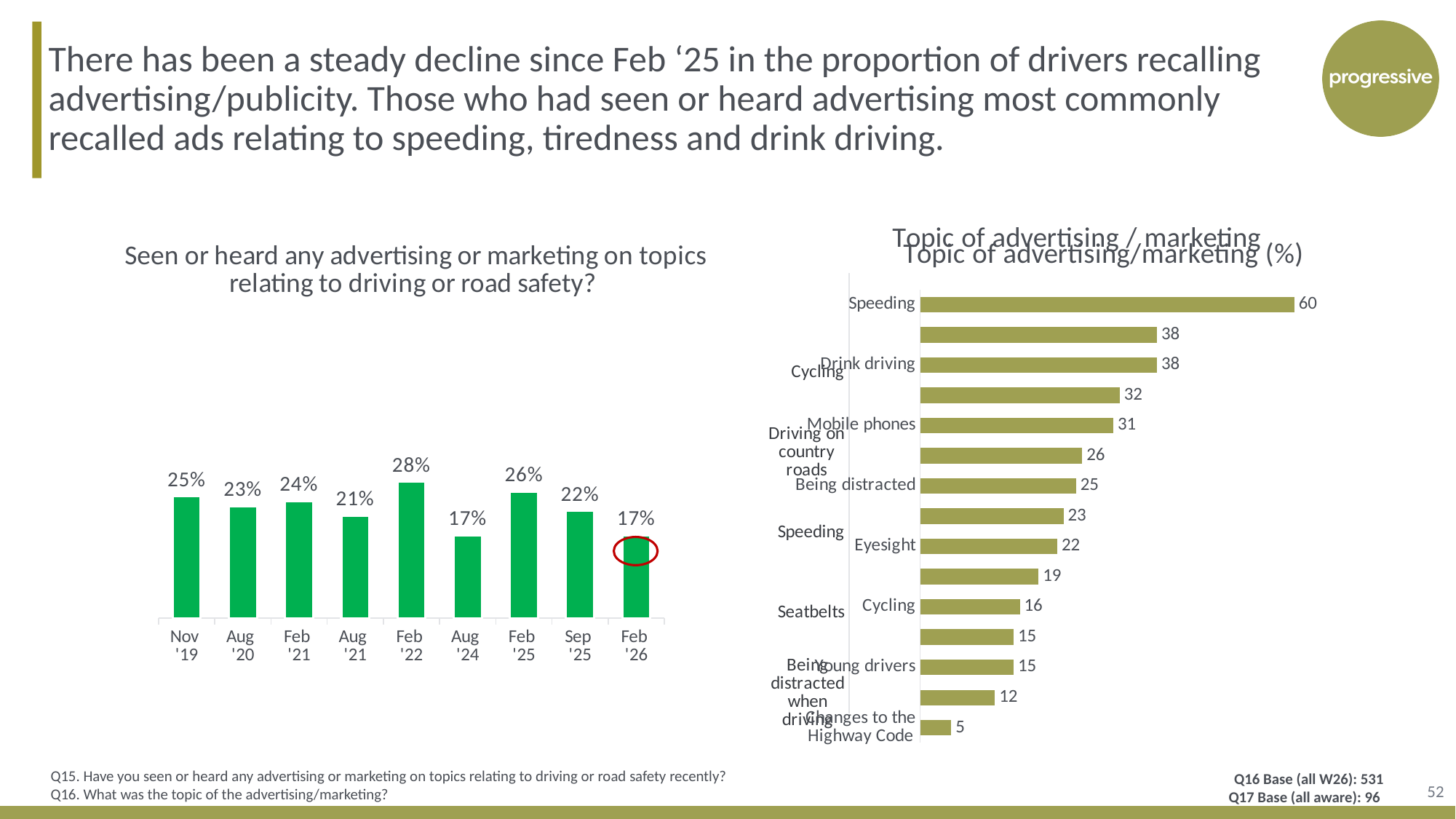
On the left chart 'Seen or heard any advertising or marketing...', do the values rise or fall from Feb '25 to Feb '26? fall On the right chart 'Topic of advertising/marketing (%)', which topic has the highest value? Speeding On the left chart 'Seen or heard any advertising or marketing...', what is the value for Feb '26? 17% On the left chart 'Seen or heard any advertising or marketing...', how many time periods are plotted? 9 On the left chart 'Seen or heard any advertising or marketing...', which period has the highest value? Feb '22 On the right chart 'Topic of advertising/marketing (%)', what is the value for Changes to the Highway Code? 5 On the left chart 'Seen or heard any advertising or marketing...', what is the lowest value shown? 17% On the left chart 'Seen or heard any advertising or marketing...', what is the difference between Feb '25 and Feb '26? 9 percentage points What kind of chart is the left chart 'Seen or heard any advertising or marketing...'? bar chart On the right chart 'Topic of advertising/marketing (%)', what is the value for Speeding? 60 On the left chart 'Seen or heard any advertising or marketing...', which is larger, Nov '19 or Aug '20? Nov '19 On the left chart 'Seen or heard any advertising or marketing on topics relating to driving or road safety?', what is the value for Feb '22? 28%